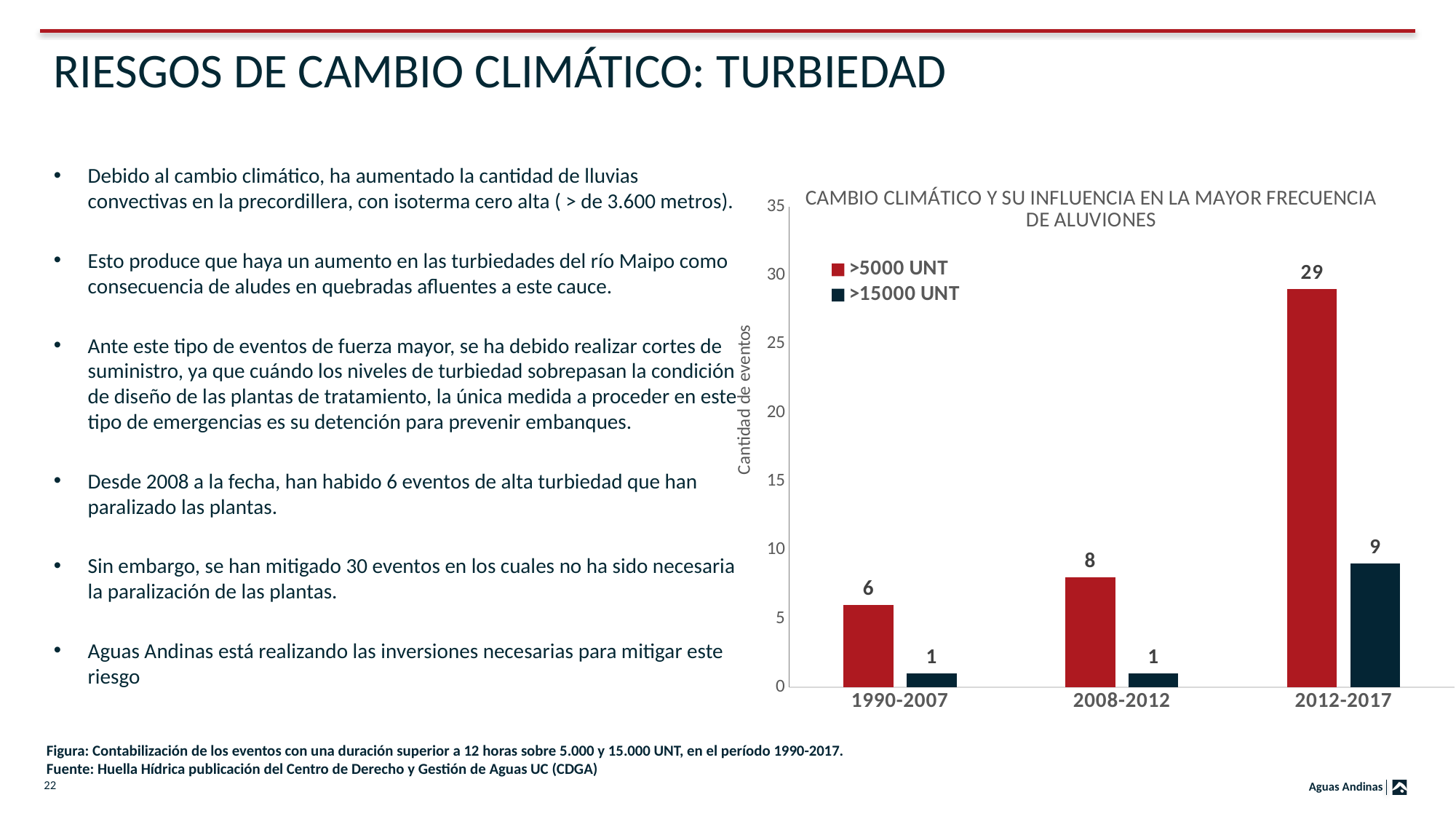
Which period has the highest value for >5000 UNT? 2012-2017 What is the value for >15000 UNT in the 2008-2012 period? 1 How many periods are shown on the x axis? 3 Which is larger: the >15000 UNT value for 2012-2017 or the >5000 UNT value for 2008-2012? >15000 UNT for 2012-2017 What is the difference between the >5000 UNT values for 2008-2012 and 1990-2007? 2 Which period has the lowest value for >5000 UNT? 1990-2007 How many series does the legend list? 2 What kind of chart is shown on the slide? Bar chart What is the value for >5000 UNT in the 2012-2017 period? 29 Do the >5000 UNT values rise or fall across the periods from 1990-2007 to 2012-2017? Rise What is the difference between the >5000 UNT and >15000 UNT values in the 2012-2017 period? 20 What is the value for >5000 UNT in the 1990-2007 period? 6